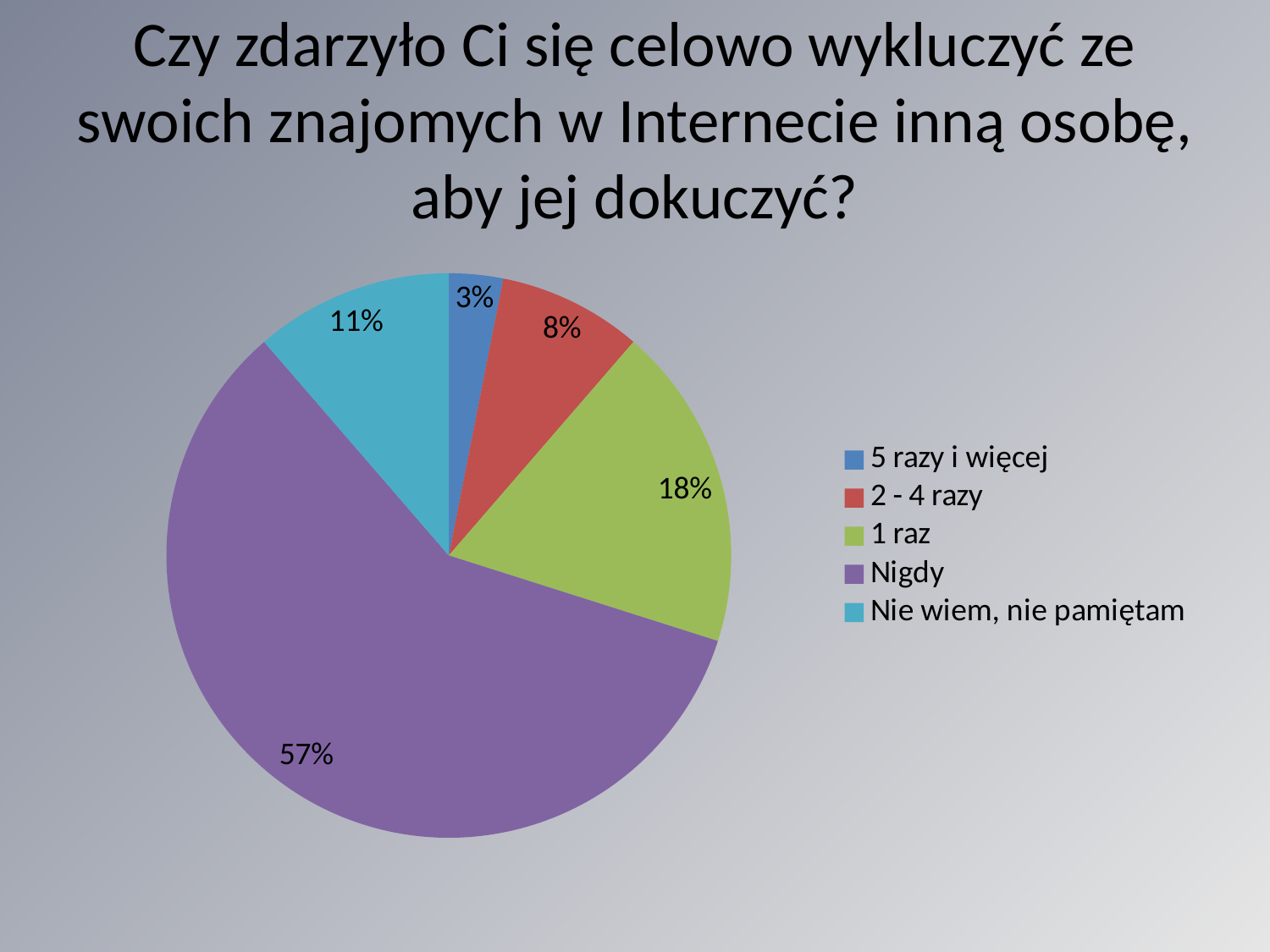
Which is larger, the value for "Nie wiem, nie pamiętam" or the value for "2 - 4 razy"? Nie wiem, nie pamiętam What colour is the slice for "Nigdy"? purple How many categories does the legend list? 5 What type of chart is shown on the slide? pie chart What is the value for "2 - 4 razy"? 8% What share of the pie does "Nigdy" represent? 57% What is the value for "Nie wiem, nie pamiętam"? 11% Which category has the largest slice? Nigdy Which category has the smallest slice? 5 razy i więcej What is the value for "1 raz"? 18% What is the difference between the values for "Nigdy" and "1 raz"? 39% What is the value for "5 razy i więcej"? 3%